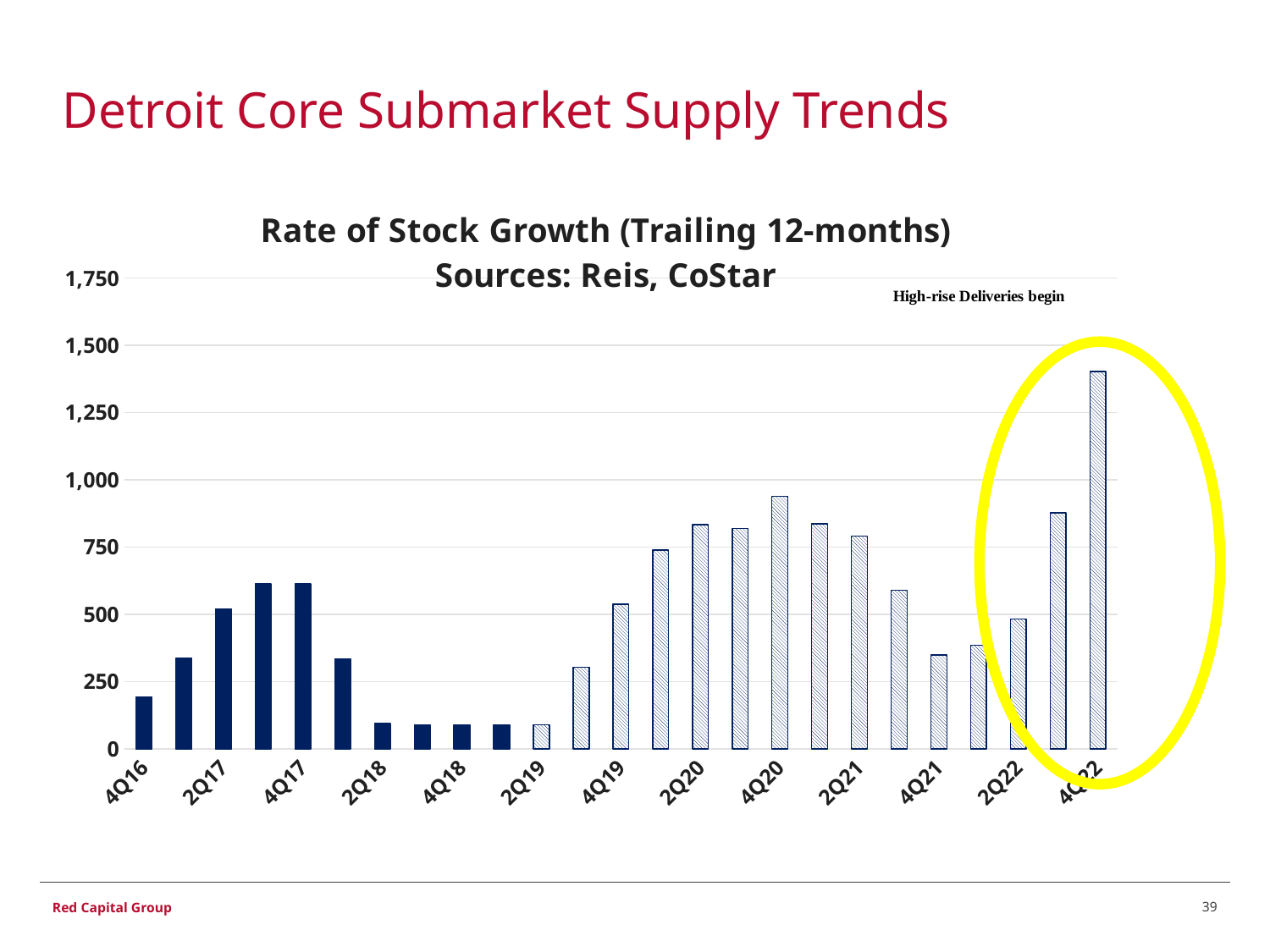
Do the values rise or fall from 2Q19 to 4Q20? rise What kind of chart is shown on the slide? Bar chart Is the value for 4Q20 greater or less than 1,000? less Which quarter has the highest bar in the chart? 4Q22 Is the value for 4Q16 greater or less than 250? less Which is larger, the value for 4Q17 or the value for 4Q16? 4Q17 Which is larger, the value for 4Q22 or the value for 4Q20? 4Q22 What annotation text appears above the circled bars at the right of the chart? High-rise Deliveries begin Is the value for 4Q22 greater or less than 1,250? greater What is the title of the chart? Rate of Stock Growth (Trailing 12-months) Sources: Reis, CoStar